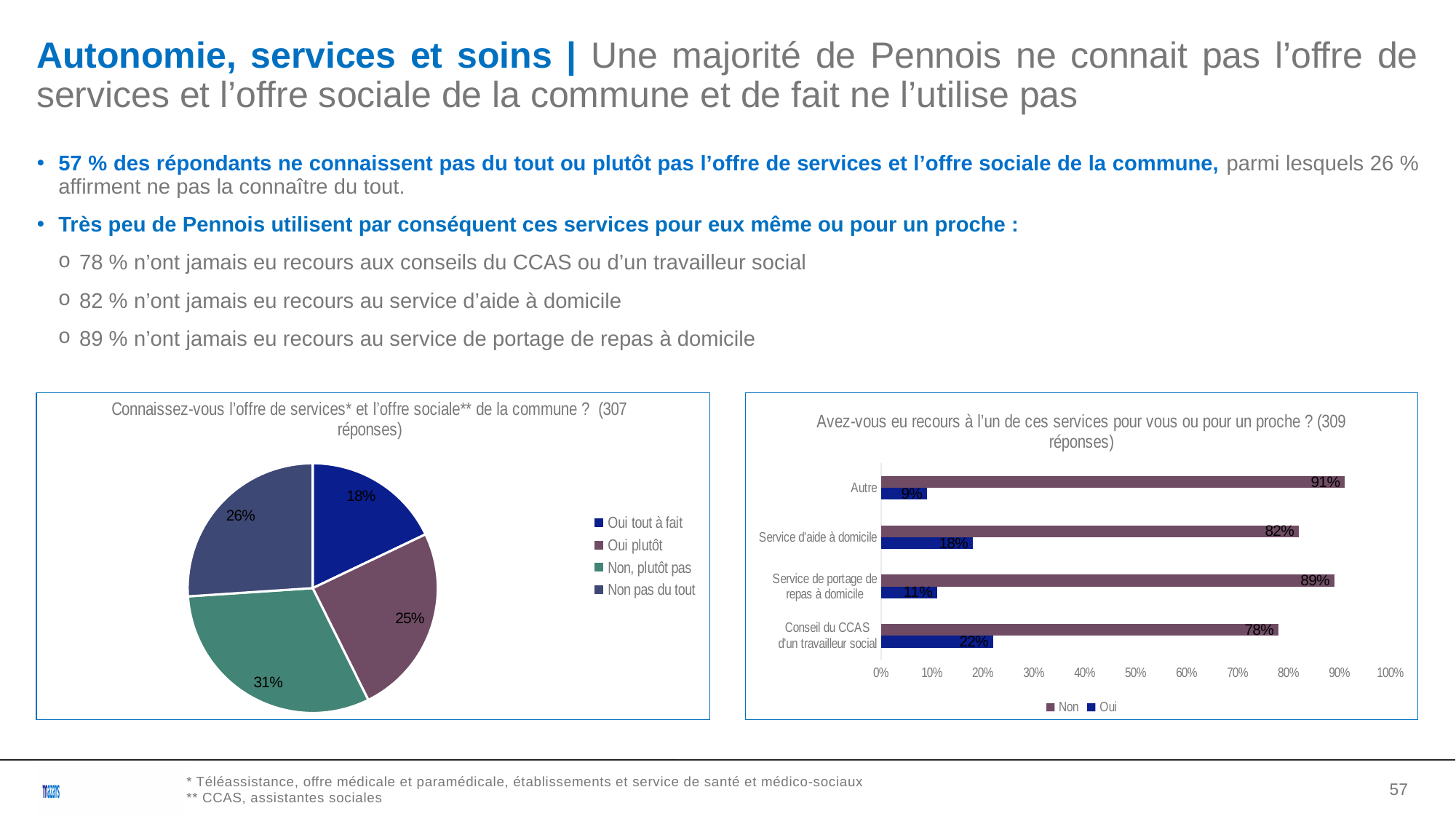
In the pie chart on the left, what share of respondents answered "Oui tout à fait"? 18% In the bar chart on the right, which service has the highest "Non" value? Autre In the pie chart on the left, which answer has the largest share? Non, plutôt pas In the pie chart on the left, what is the difference between the shares for "Non pas du tout" and "Oui plutôt"? 1% What kind of chart is the chart on the right ("Avez-vous eu recours à l'un de ces services...")? Bar chart In the pie chart on the left, which answer has the smallest share? Oui tout à fait In the pie chart on the left, how many answer categories does the legend list? 4 In the bar chart on the right, what is the "Oui" value for "Conseil du CCAS d'un travailleur social"? 22% In the bar chart on the right, which service has the lowest "Oui" value? Autre In the bar chart on the right, how many series does the legend list? 2 In the pie chart on the left, what share of respondents answered "Non, plutôt pas"? 31% In the bar chart on the right, what is the "Non" value for "Service d'aide à domicile"? 82%